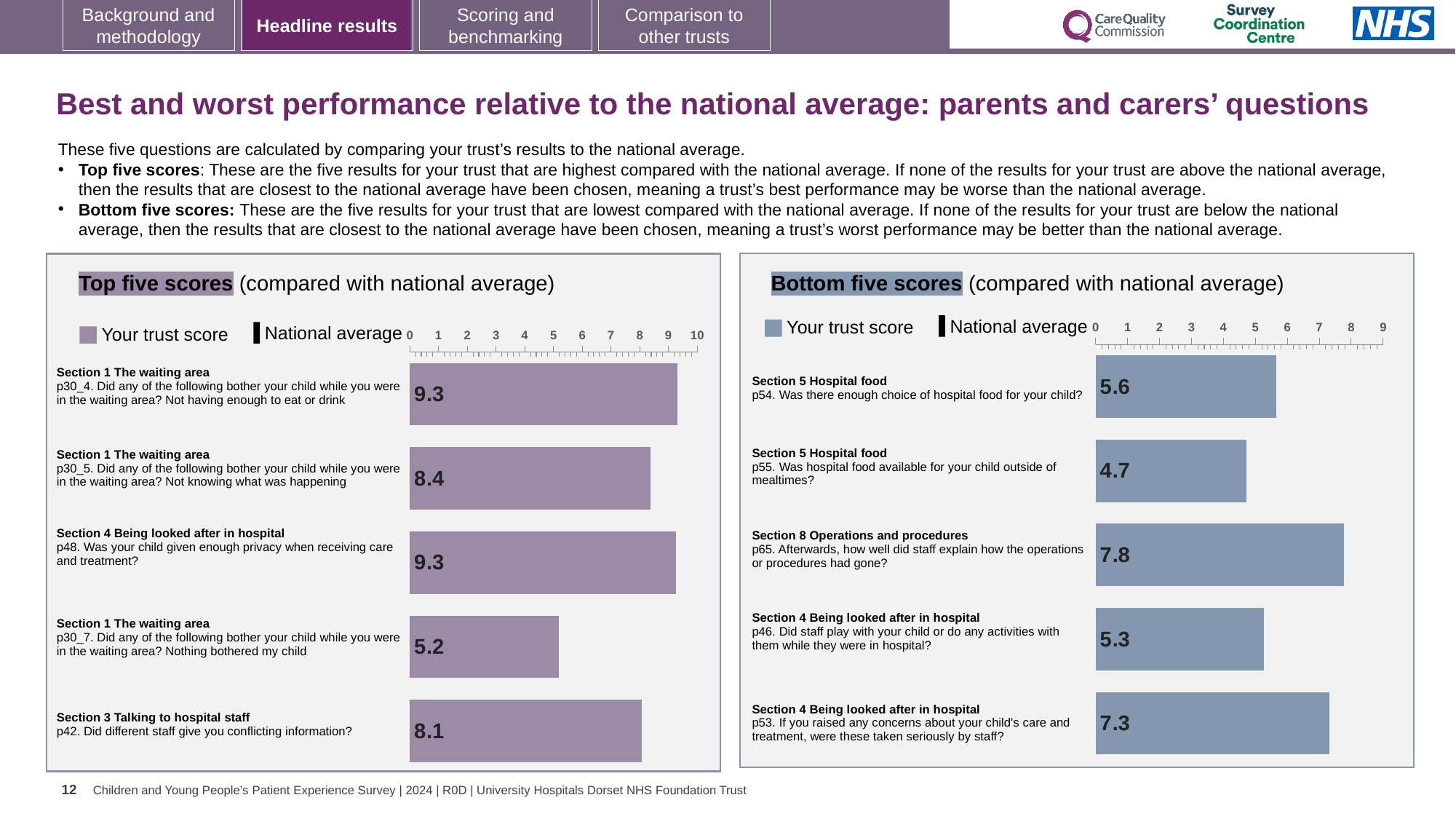
In the Bottom five scores chart, which question has the lowest trust score? p55. Was hospital food available for your child outside of mealtimes? In the Bottom five scores chart, which question has the highest trust score? p65. Afterwards, how well did staff explain how the operations or procedures had gone? In the Top five scores chart, what is the difference between the trust scores for p30_5 and p30_7? 3.2 What type of chart is used in the Top five scores panel? Bar chart In the Bottom five scores chart, what is the difference between the trust scores for p65 and p55? 3.1 In the Bottom five scores chart, which has the larger trust score: p46 or p53? p53 In the Bottom five scores chart, what is the trust score for p54 (Was there enough choice of hospital food for your child?)? 5.6 How many entries does the legend of the Bottom five scores chart list? 2 In the Top five scores chart, what is the trust score for p42 (Did different staff give you conflicting information?)? 8.1 In the Top five scores chart, which question has the lowest trust score? p30_7. Did any of the following bother your child while you were in the waiting area? Nothing bothered my child In the Top five scores chart, how many questions are plotted? 5 In the Top five scores chart, what is the trust score for p48 (Was your child given enough privacy when receiving care and treatment?)? 9.3